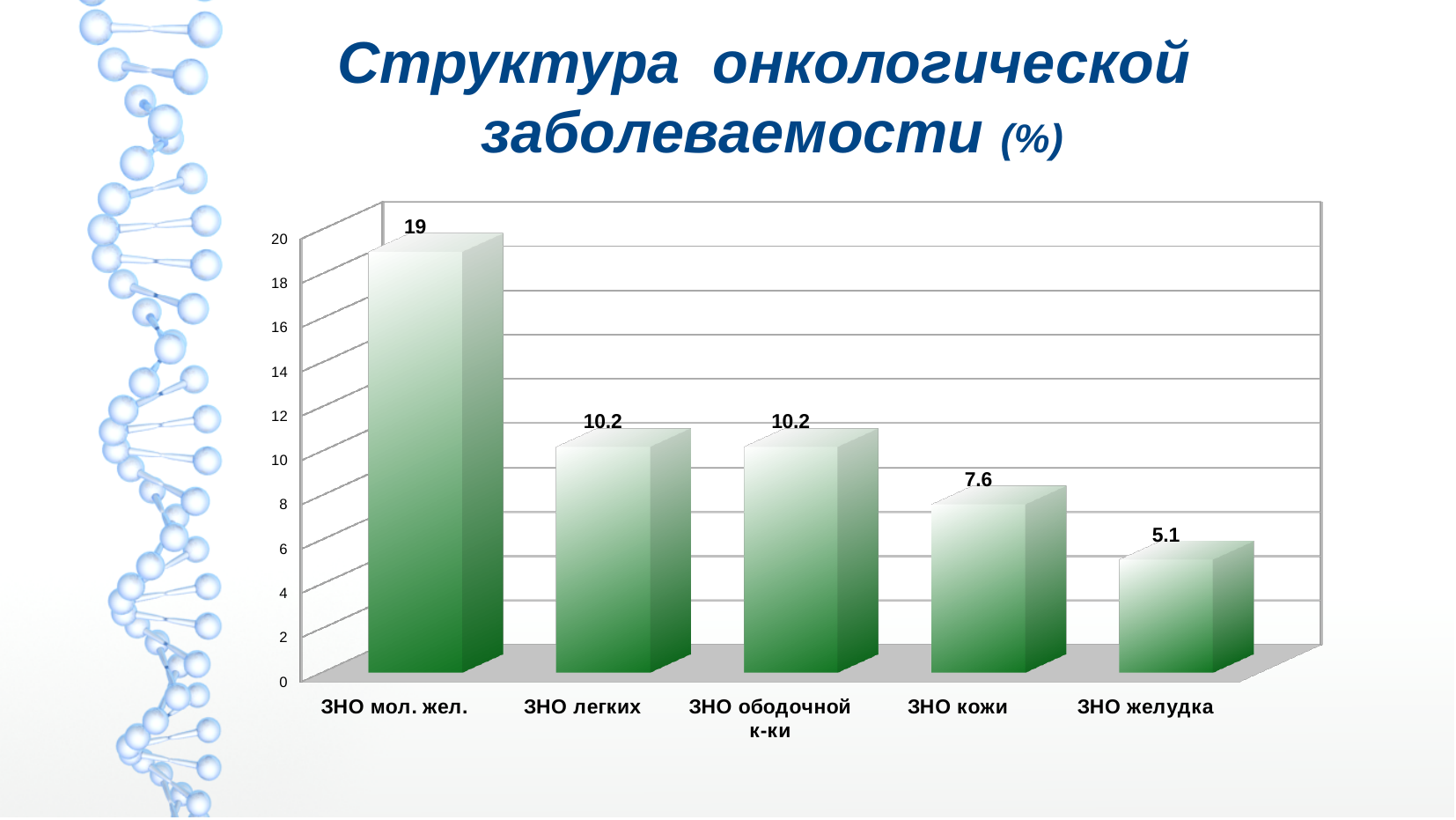
What is the value for ЗНО кожи? 7.6 What is the title of the chart on the slide? Структура онкологической заболеваемости (%) Which category has the lowest value? ЗНО желудка What is the value for ЗНО мол. жел.? 19 What is the difference between the values for ЗНО кожи and ЗНО желудка? 2.5 What is the value for ЗНО желудка? 5.1 What kind of chart is shown on the slide? bar chart Which category has the highest value? ЗНО мол. жел. Which is larger, the value for ЗНО кожи or the value for ЗНО желудка? ЗНО кожи What is the value for ЗНО легких? 10.2 What is the difference between the values for ЗНО мол. жел. and ЗНО легких? 8.8 How many categories are shown in the chart? 5